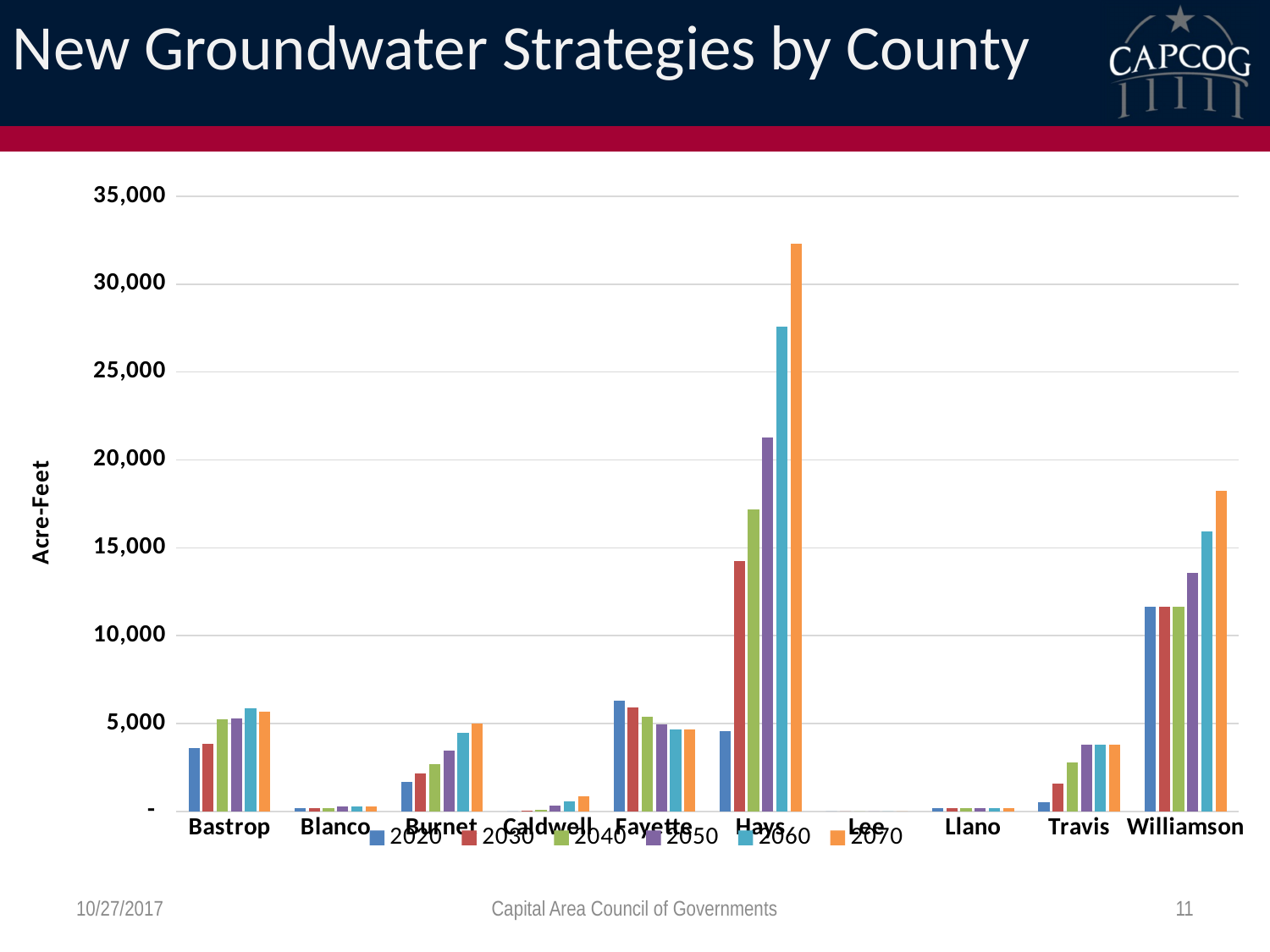
Is the 2070 value for Williamson greater or less than 20,000? less How many counties are shown along the x axis? 10 How many series does the legend list? 6 Is the 2070 value for Hays greater or less than 30,000? greater What kind of chart is shown on the slide? bar chart What is the label on the vertical axis? Acre-Feet Is the 2020 value for Bastrop greater or less than 5,000? less Do the values for Hays rise or fall from 2020 to 2070? rise Which county has the tallest bar on the chart? Hays Do the values for Fayette rise or fall from 2020 to 2070? fall Which year series has the highest value for Hays? 2070 Which is larger, the 2070 value for Hays or the 2070 value for Williamson? Hays